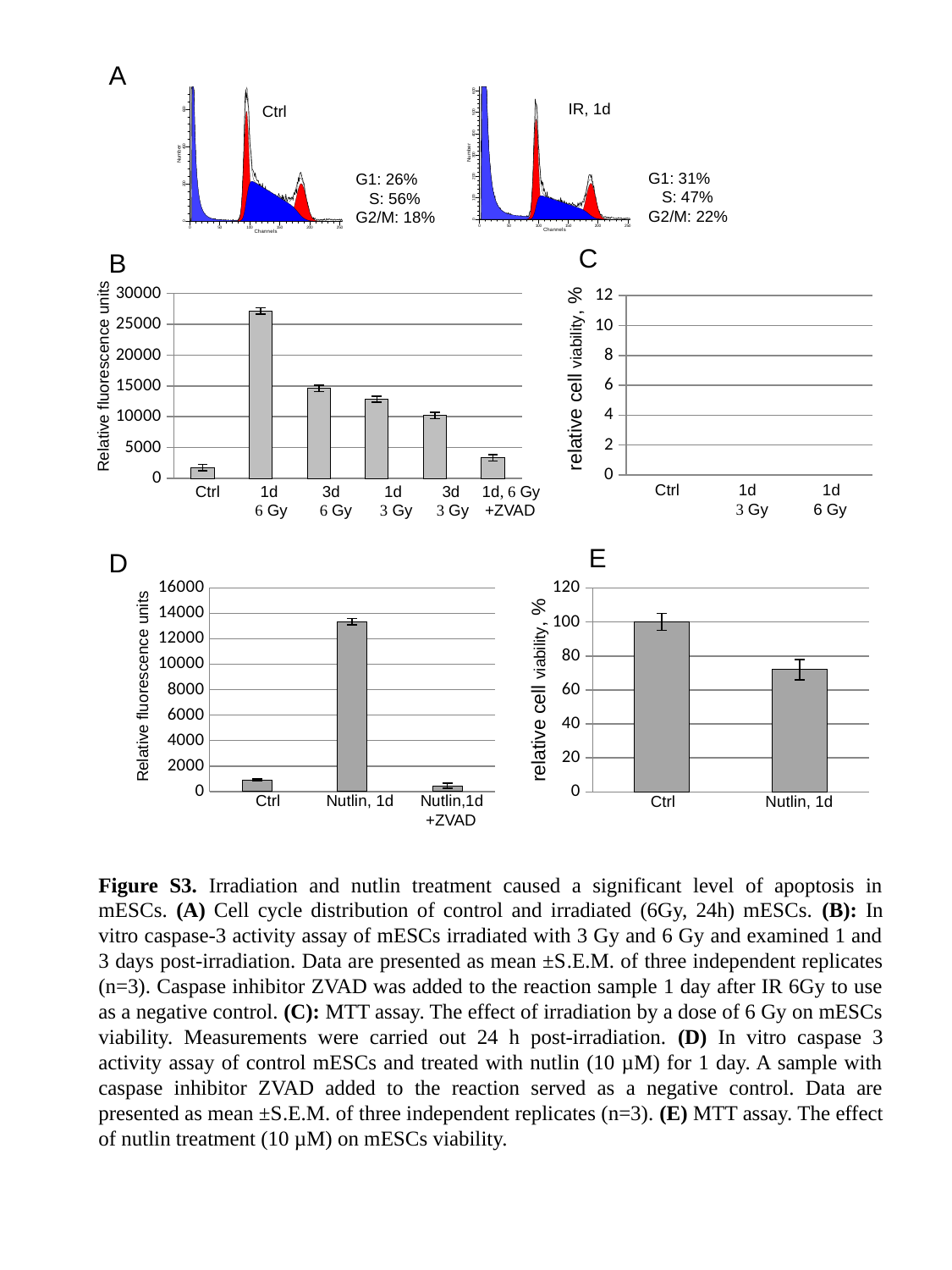
In panel A, what is the S phase percentage for the IR, 1d sample? 47% In chart B, is the value for 1d 3 Gy greater or less than 15000? less In chart D, is the value for Nutlin, 1d greater or less than 12000? greater What kind of chart is chart E? bar chart In chart E, is the value for Nutlin, 1d greater or less than 80? less In chart D, which category has the highest relative fluorescence units? Nutlin, 1d In panel A, what is the G1 percentage for the Ctrl sample? 26% In chart B, how many categories are shown on the x axis? 6 In chart B, which category has the highest relative fluorescence units? 1d 6 Gy In chart B, which category has the lowest relative fluorescence units? Ctrl In chart E, which is larger, the relative cell viability for Ctrl or for Nutlin, 1d? Ctrl